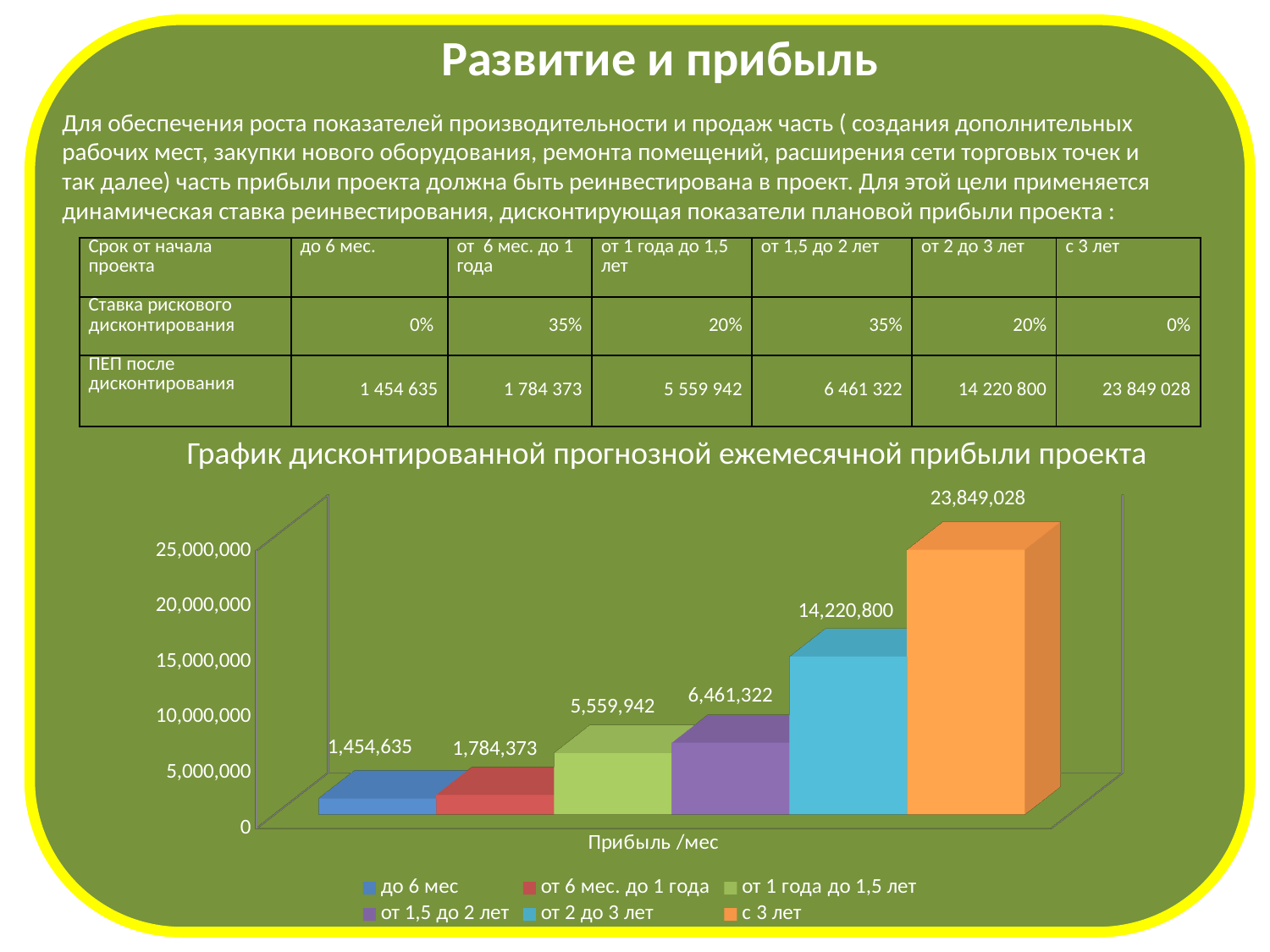
What is the difference between the 'от 1,5 до 2 лет' bar and the 'от 1 года до 1,5 лет' bar? 901,380 What is the value of the 'с 3 лет' bar in the chart? 23,849,028 What is the value of the 'от 1 года до 1,5 лет' bar in the chart? 5,559,942 What is the value of the 'до 6 мес' bar in the chart? 1,454,635 What kind of chart is shown on the slide? Bar chart What is the value of the 'от 2 до 3 лет' bar in the chart? 14,220,800 Which is larger: the 'от 6 мес. до 1 года' bar or the 'от 1,5 до 2 лет' bar? от 1,5 до 2 лет How many series does the legend list? 6 Which series has the highest value in the chart? с 3 лет What is the difference between the 'с 3 лет' bar and the 'от 2 до 3 лет' bar? 9,628,228 Which series has the lowest value in the chart? до 6 мес What is the title of the chart? График дисконтированной прогнозной ежемесячной прибыли проекта